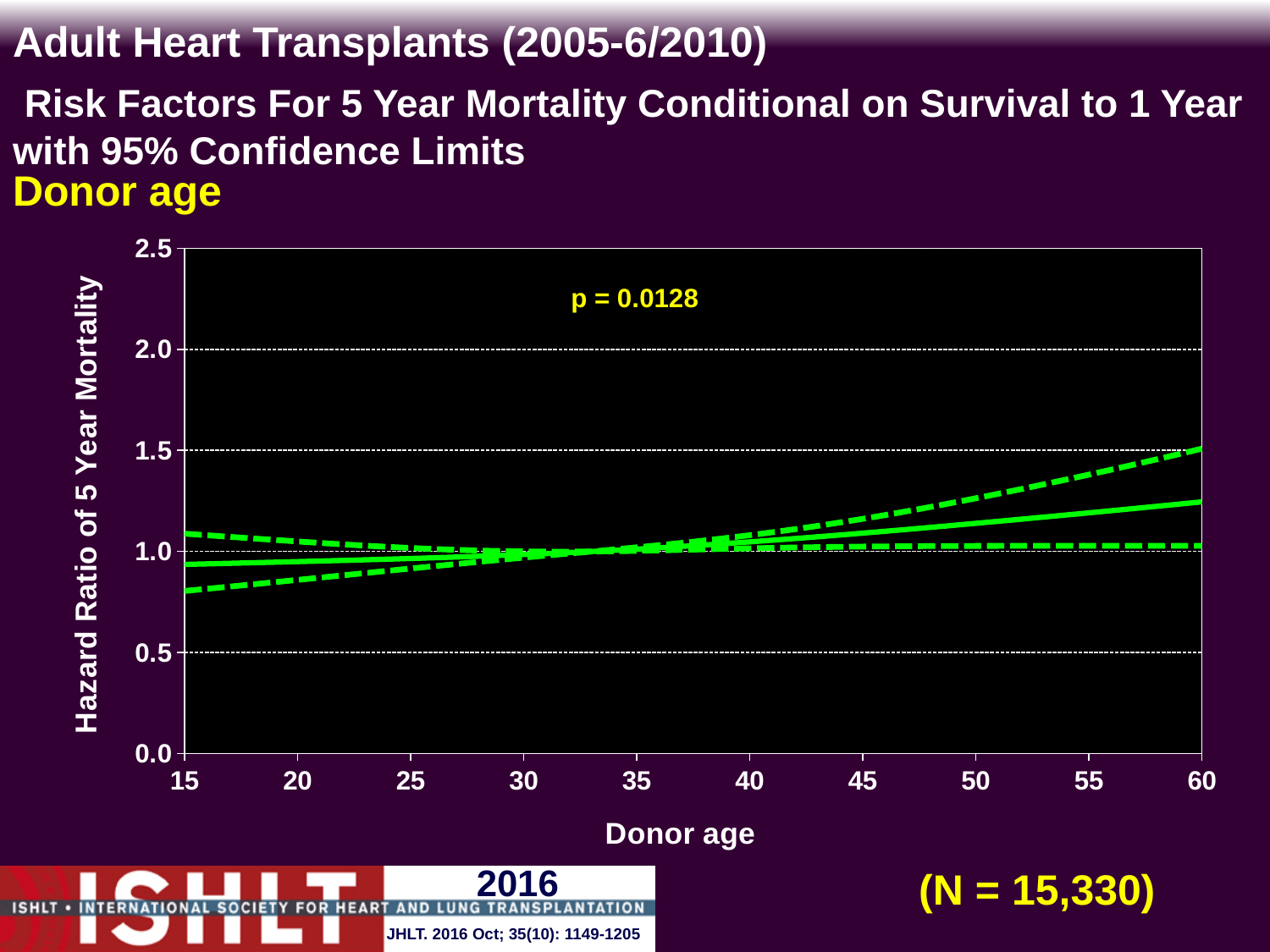
Is the upper dashed confidence limit at donor age 60 greater or less than 2.0? less Is the hazard ratio on the solid line at donor age 60 greater or less than 1.0? greater What kind of chart is shown on the slide? line chart What p-value is printed on the chart? p = 0.0128 How many tick labels are shown on the donor age axis? 10 Is the upper dashed confidence limit at donor age 60 greater or less than 1.0? greater What sample size (N) is shown on the slide? N = 15,330 Does the solid hazard ratio line rise or fall as donor age increases from 15 to 60? rise How many lines are plotted on the chart? 3